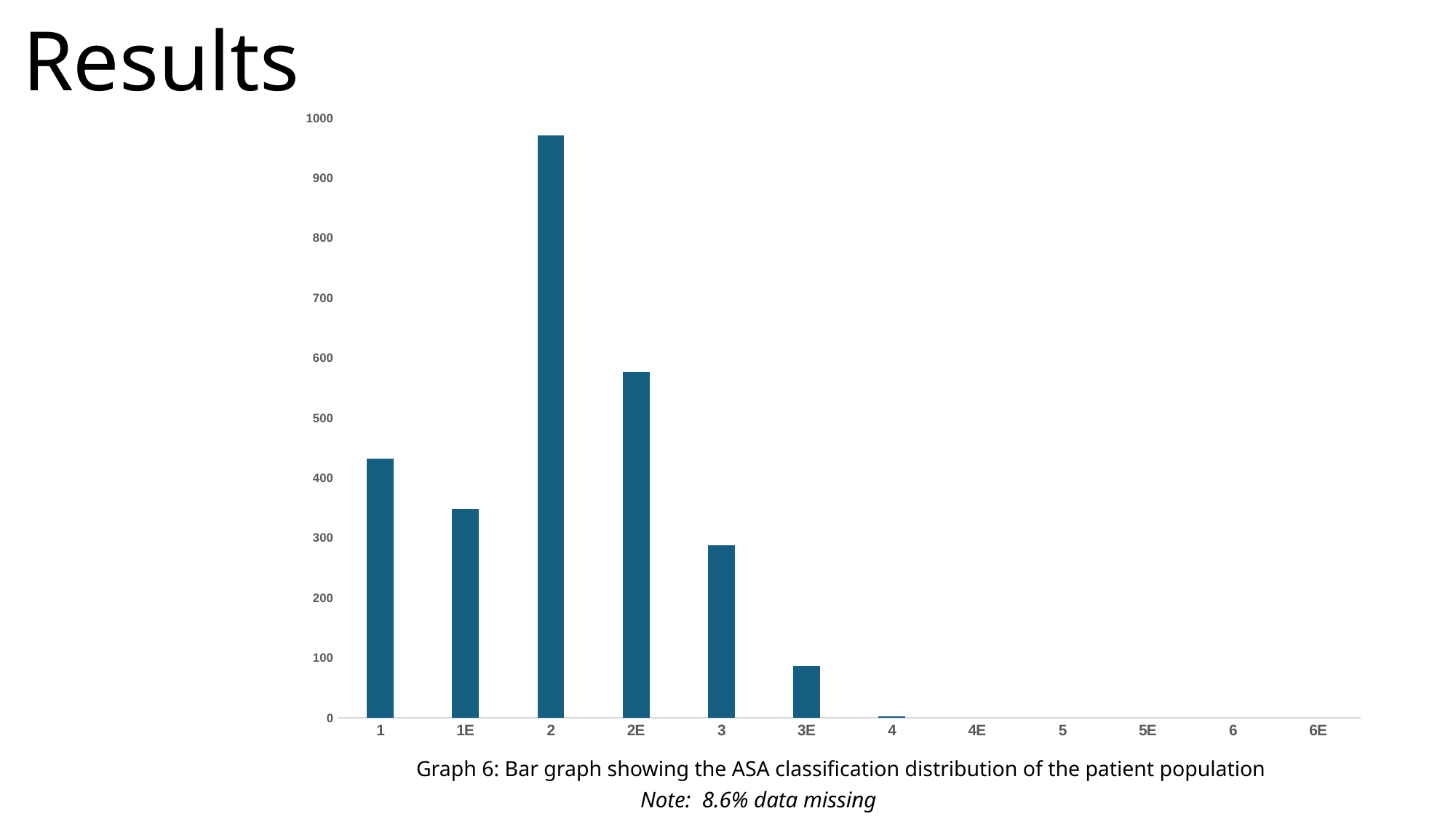
Is the value for category 3E greater or less than 100? less How many ASA classification categories are shown on the x axis? 12 Is the value for category 1 greater or less than 400? greater Which ASA classification category has the highest bar? 2 Is the value for category 1E greater or less than 400? less Which has the larger value, category 2E or category 3? 2E According to the note below the chart, what percentage of data is missing? 8.6% Which has the larger value, category 1 or category 1E? 1 What kind of chart is shown on the slide? Bar chart